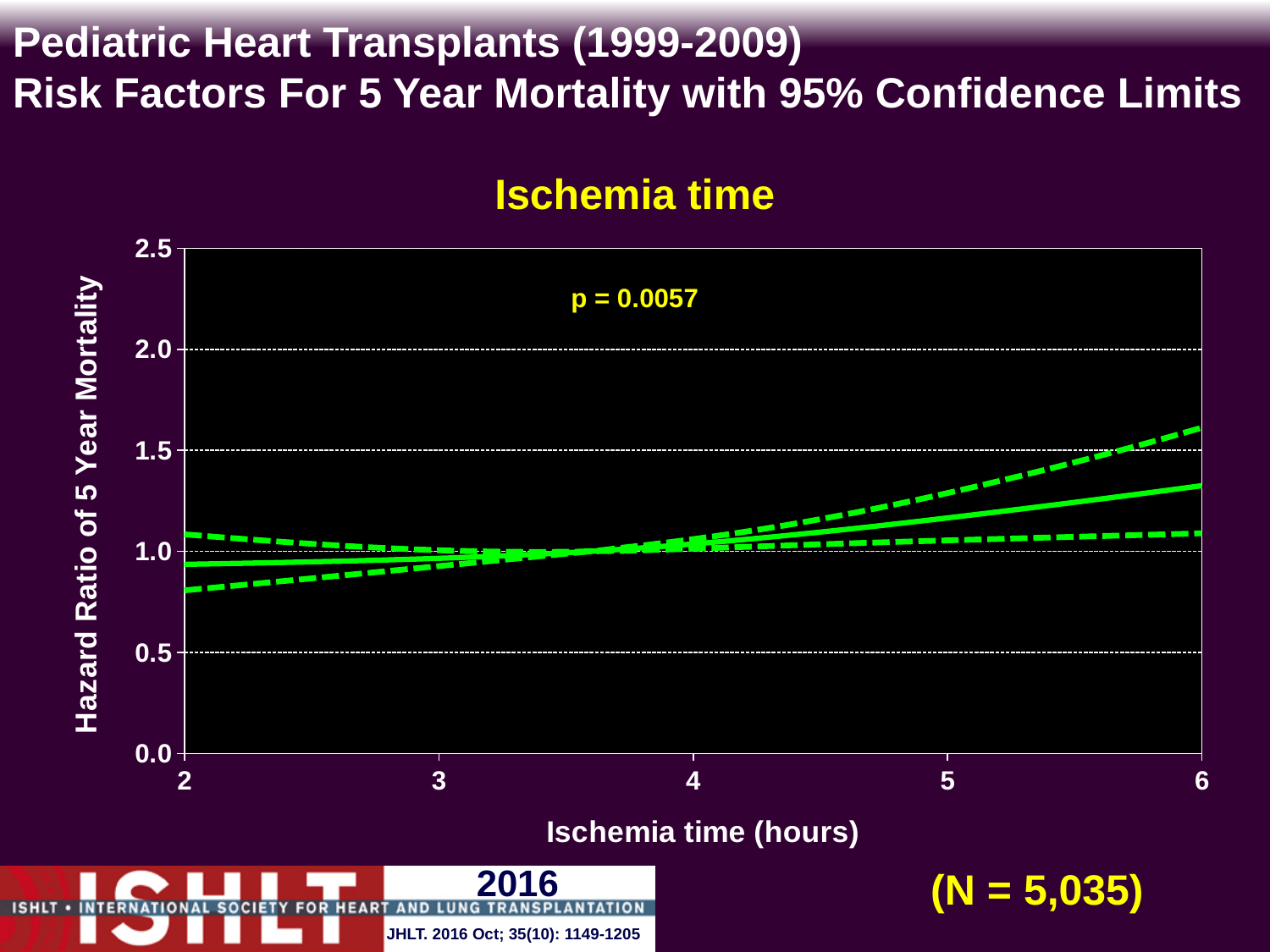
What is the label of the x axis? Ischemia time (hours) Is the hazard ratio (solid line) at 6 hours of ischemia time greater or less than 1.5? less What kind of chart is shown on the slide? line chart Does the solid hazard ratio line rise or fall as ischemia time increases from 2 to 6 hours? rise Is the upper 95% confidence limit (upper dashed line) at 6 hours greater or less than 1.5? greater What is the title of the chart? Ischemia time Is the lower 95% confidence limit (lower dashed line) at 2 hours greater or less than 1.0? less How many lines are plotted on the chart? 3 What is the p-value printed on the chart? p = 0.0057 Is the hazard ratio (solid line) at 6 hours greater or less than the hazard ratio at 2 hours? greater